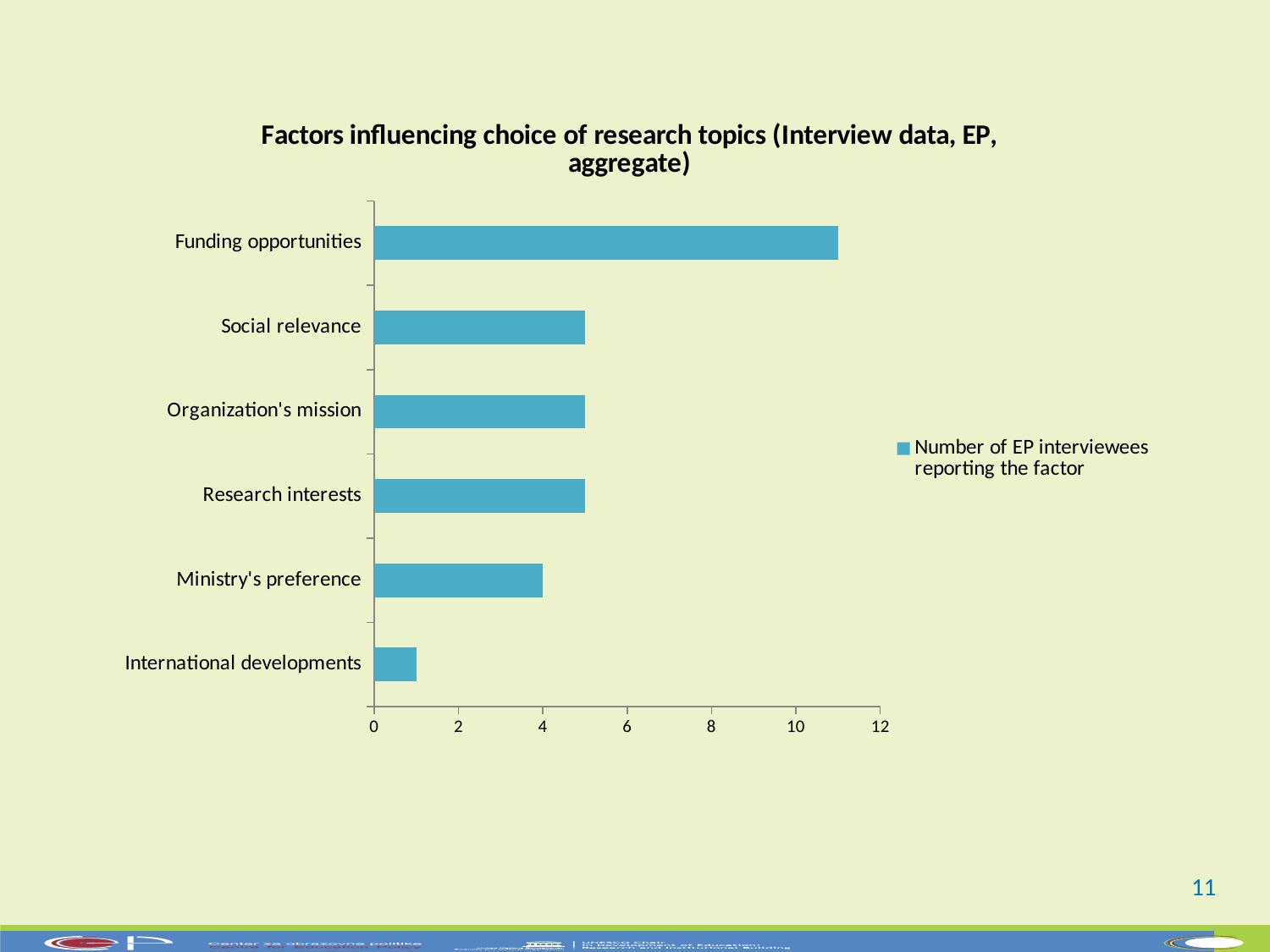
What is the legend entry for the series shown on the chart? Number of EP interviewees reporting the factor Which is larger, the value for Funding opportunities or the value for Research interests? Funding opportunities How many series does the legend list? 1 Is the value for International developments greater or less than 2? less Which factor has the lowest number of EP interviewees reporting it? International developments What is the value for Ministry's preference? 4 How many factors (categories) are shown on the chart? 6 Is the value for Funding opportunities greater or less than 10? greater Is the value for Social relevance greater or less than 4? greater What kind of chart is shown on the slide? bar chart Which factor has the highest number of EP interviewees reporting it? Funding opportunities Which is larger, the value for Ministry's preference or the value for International developments? Ministry's preference